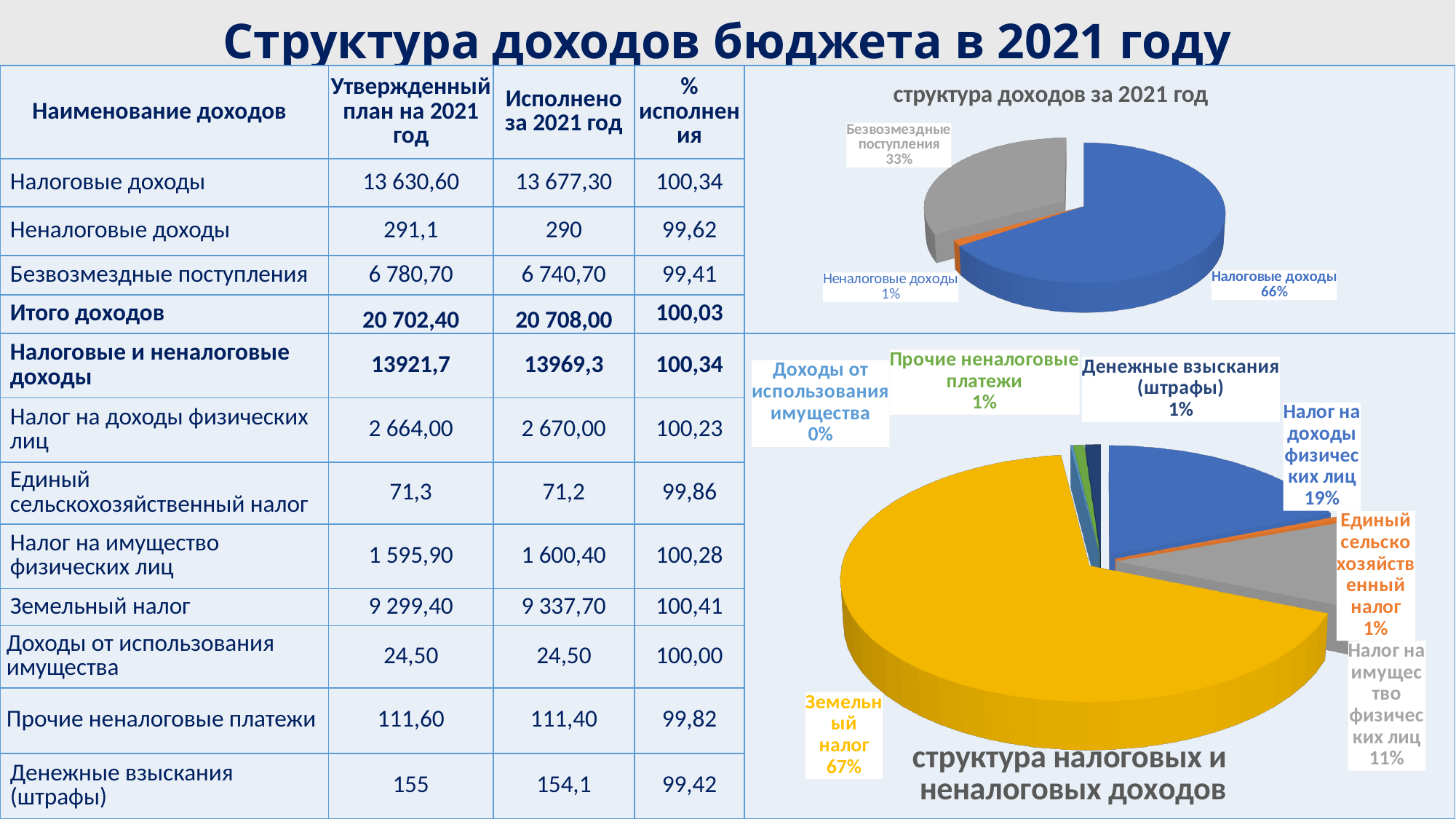
In the bottom chart 'структура налоговых и неналоговых доходов', which is larger: 'Налог на доходы физических лиц' or 'Налог на имущество физических лиц'? Налог на доходы физических лиц In the top chart 'структура доходов за 2021 год', what share does 'Безвозмездные поступления' have? 33% In the top chart 'структура доходов за 2021 год', what share does 'Налоговые доходы' have? 66% In the top chart 'структура доходов за 2021 год', which category has the largest share? Налоговые доходы In the top chart 'структура доходов за 2021 год', what share does 'Неналоговые доходы' have? 1% In the top chart 'структура доходов за 2021 год', which category has the smallest share? Неналоговые доходы In the top chart 'структура доходов за 2021 год', how many slices does the pie have? 3 In the bottom chart 'структура налоговых и неналоговых доходов', what is the difference in percentage points between 'Земельный налог' and 'Налог на доходы физических лиц'? 48 What type of chart is the bottom chart 'структура налоговых и неналоговых доходов'? Pie chart